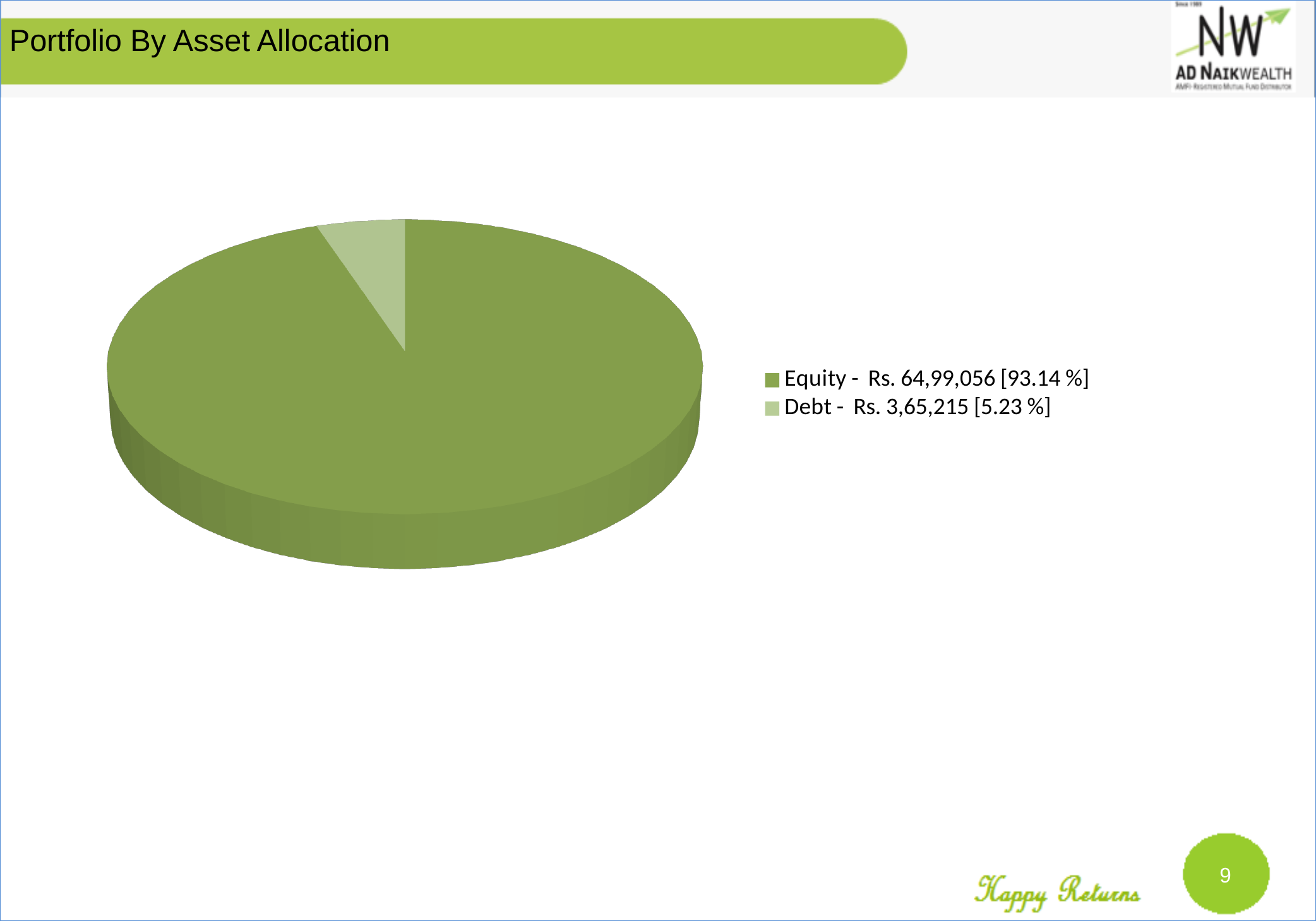
Which category has the largest slice in the pie chart? Equity What share of the pie does Equity represent? 93.14 % What kind of chart is shown on the slide? Pie chart What is the value for Equity in the pie chart? Rs. 64,99,056 Which category is shown in the lighter green colour in the pie chart? Debt How many categories does the legend of the pie chart list? 2 What share of the pie does Debt represent? 5.23 % What is the value for Debt in the pie chart? Rs. 3,65,215 What is the title of the slide containing the pie chart? Portfolio By Asset Allocation Which category has the smallest slice in the pie chart? Debt What is the difference between the Equity value and the Debt value? Rs. 61,33,841 Which is larger, the value for Equity or the value for Debt? Equity